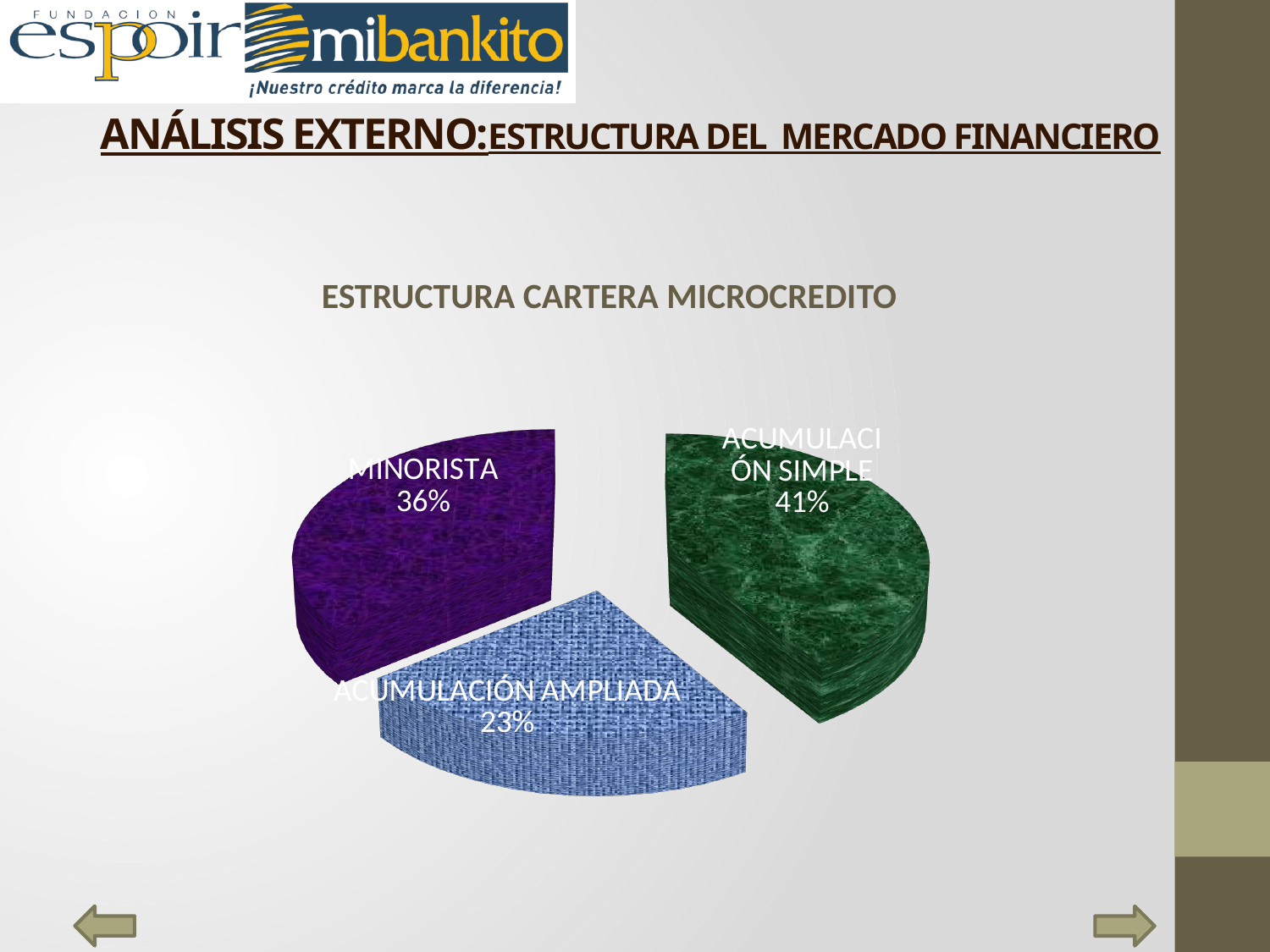
Which is larger, the share for MINORISTA or the share for ACUMULACIÓN AMPLIADA? MINORISTA What share of the pie does ACUMULACIÓN SIMPLE represent? 41% What kind of chart is shown on the slide? pie chart How many slices does the pie chart have? 3 What share of the pie does MINORISTA represent? 36% What colour is the MINORISTA slice? purple What is the difference in percentage points between ACUMULACIÓN SIMPLE and MINORISTA? 5 What is the title of the chart? ESTRUCTURA CARTERA MICROCREDITO What share of the pie does ACUMULACIÓN AMPLIADA represent? 23% What is the difference in percentage points between MINORISTA and ACUMULACIÓN AMPLIADA? 13 Which category has the smallest share of the pie? ACUMULACIÓN AMPLIADA Which category has the largest share of the pie? ACUMULACIÓN SIMPLE